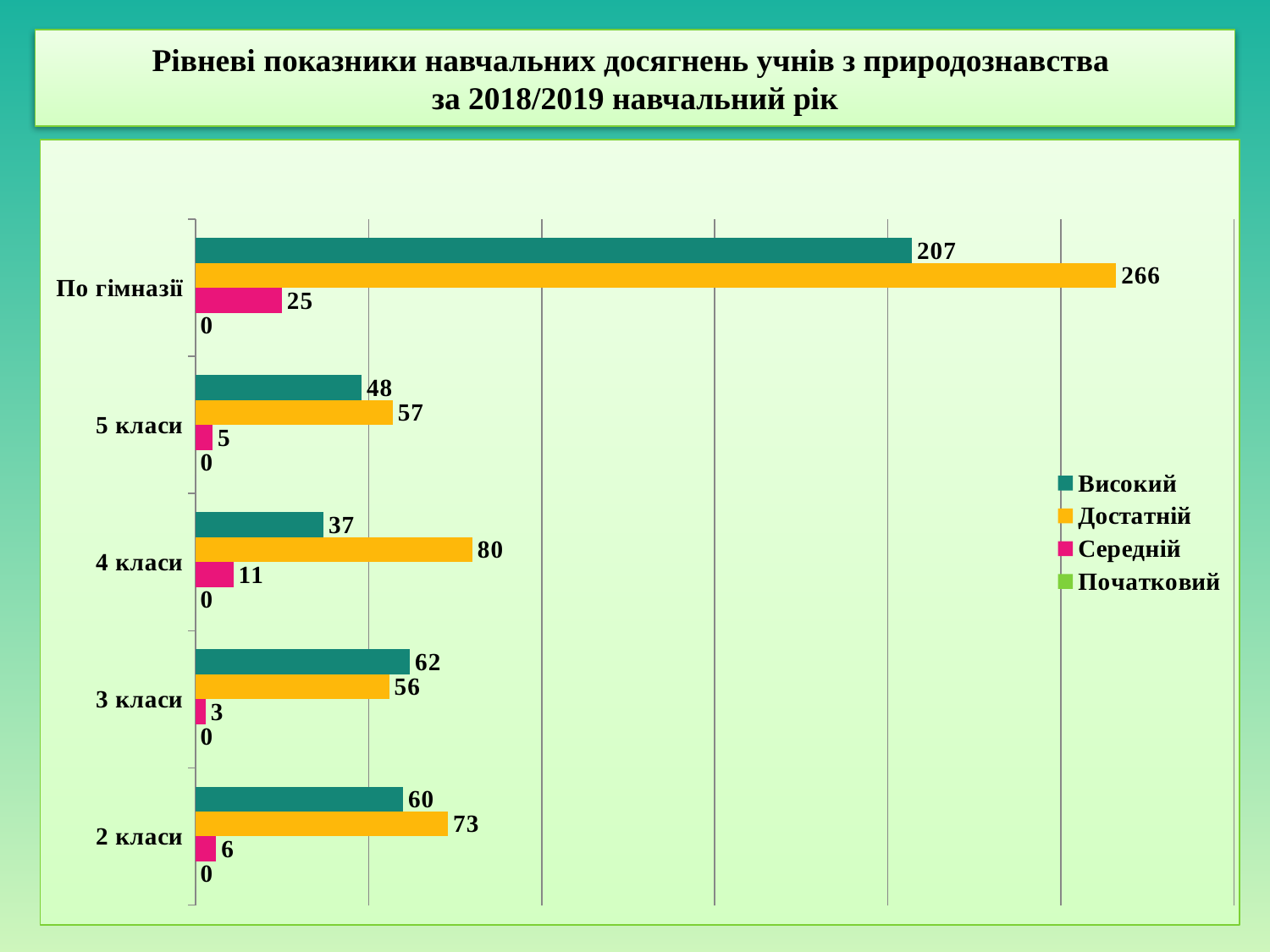
What is the value of Високий for 3 класи? 62 How many series does the legend list? 4 Which colour represents the Середній series in the legend? Pink Which class group has the highest Достатній value (excluding По гімназії)? 4 класи What kind of chart is shown on the slide? Bar chart What is the value of Початковий for 2 класи? 0 What is the value of Достатній for По гімназії? 266 What is the value of Середній for 4 класи? 11 Which class group has the lowest Середній value? 3 класи Which is larger for 3 класи, Високий or Достатній? Високий How many categories are shown on the vertical axis? 5 What is the difference between Достатній and Високий for 4 класи? 43